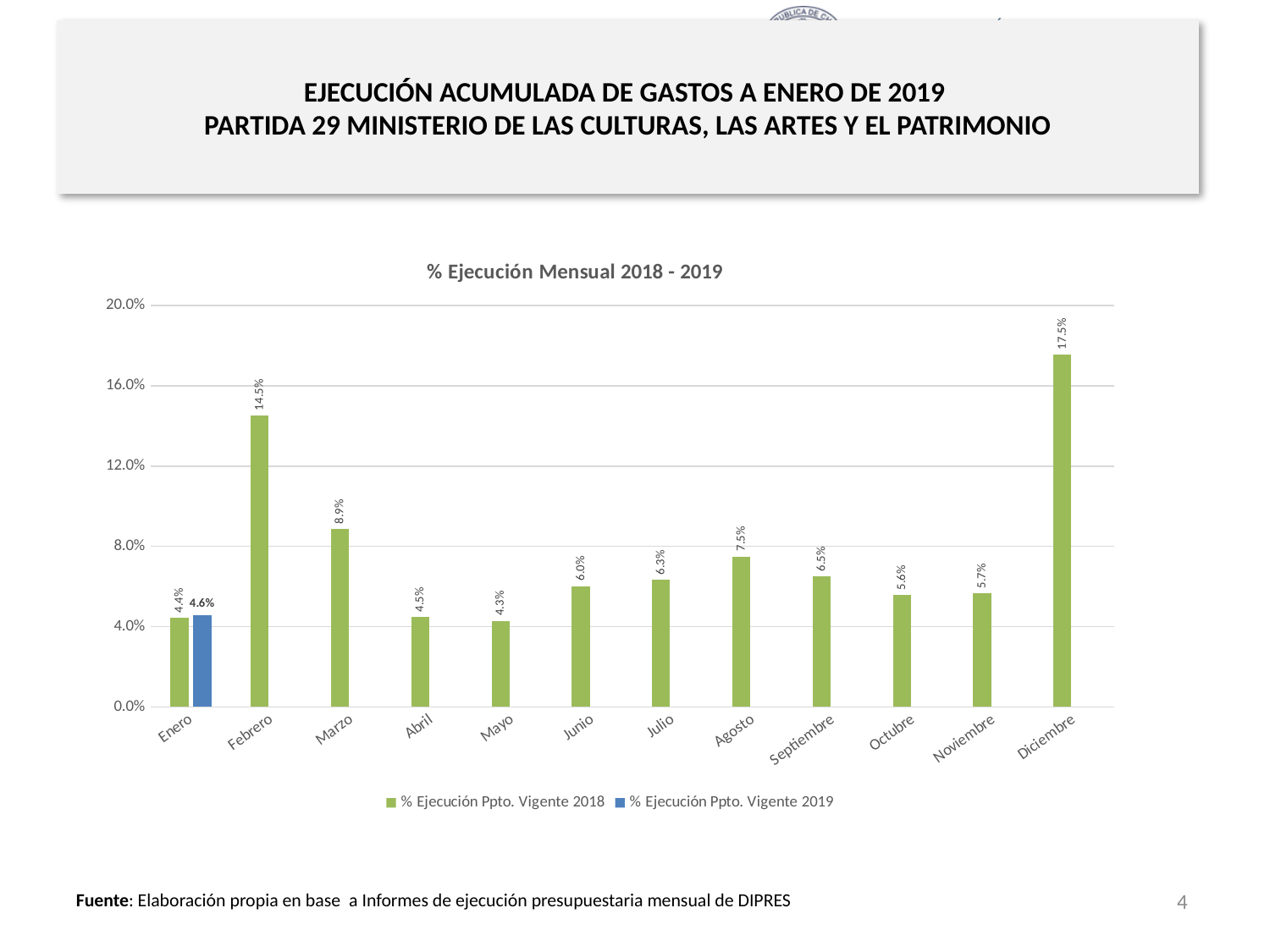
How many series does the legend list? 2 What is the difference between the Diciembre and Febrero values in the % Ejecución Ppto. Vigente 2018 series? 3.0% Which month has the lowest value in the % Ejecución Ppto. Vigente 2018 series? Mayo How many months are shown on the x axis? 12 What is the value for Enero in the % Ejecución Ppto. Vigente 2019 series? 4.6% Which is larger for Enero: the 2018 value or the 2019 value? 2019 (4.6%) Is the value for Marzo in the 2018 series greater or less than 8.0%? greater What is the value for Febrero in the % Ejecución Ppto. Vigente 2018 series? 14.5% What is the value for Agosto in the % Ejecución Ppto. Vigente 2018 series? 7.5% What is the title of the chart? % Ejecución Mensual 2018 - 2019 What kind of chart is shown on the slide? Bar chart Which month has the highest value in the % Ejecución Ppto. Vigente 2018 series? Diciembre